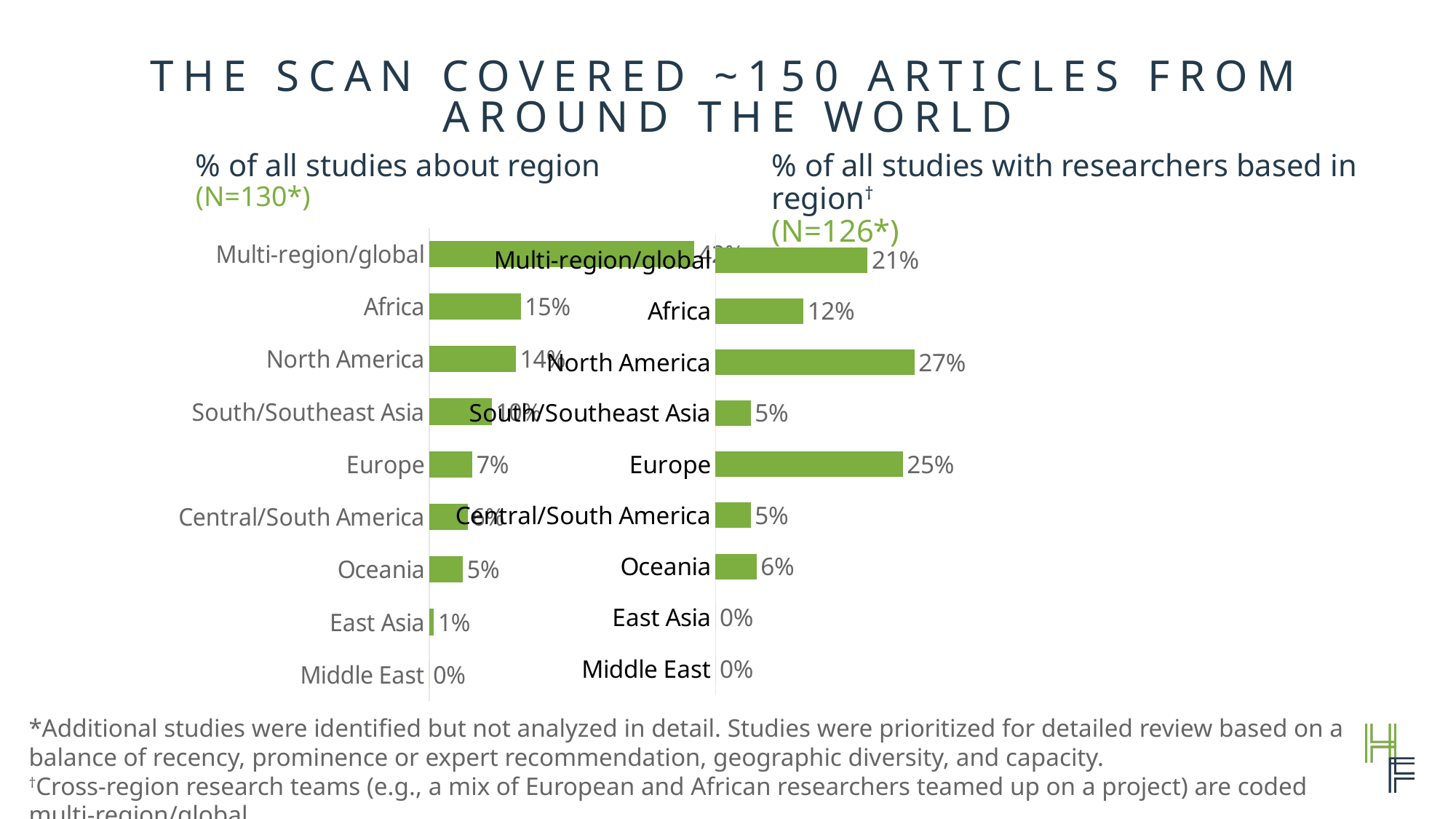
In the chart '% of all studies with researchers based in region', what is the difference between Europe and Africa? 13% In the chart '% of all studies about region', which region has the highest value? Multi-region/global In the chart '% of all studies with researchers based in region', which region has the highest value? North America How many regions are listed in the chart '% of all studies with researchers based in region'? 9 In the chart '% of all studies with researchers based in region', what is the value for Multi-region/global? 21% In the chart '% of all studies with researchers based in region', what is the value for North America? 27% In the chart '% of all studies about region', what is the value for Africa? 15% What type of chart is used for '% of all studies about region'? Bar chart In the chart '% of all studies about region', which is larger, Oceania or East Asia? Oceania In the chart '% of all studies with researchers based in region', which is larger, Oceania or South/Southeast Asia? Oceania In the chart '% of all studies about region', what is the value for Europe? 7% In the chart '% of all studies about region', what is the difference between Africa and North America? 1%